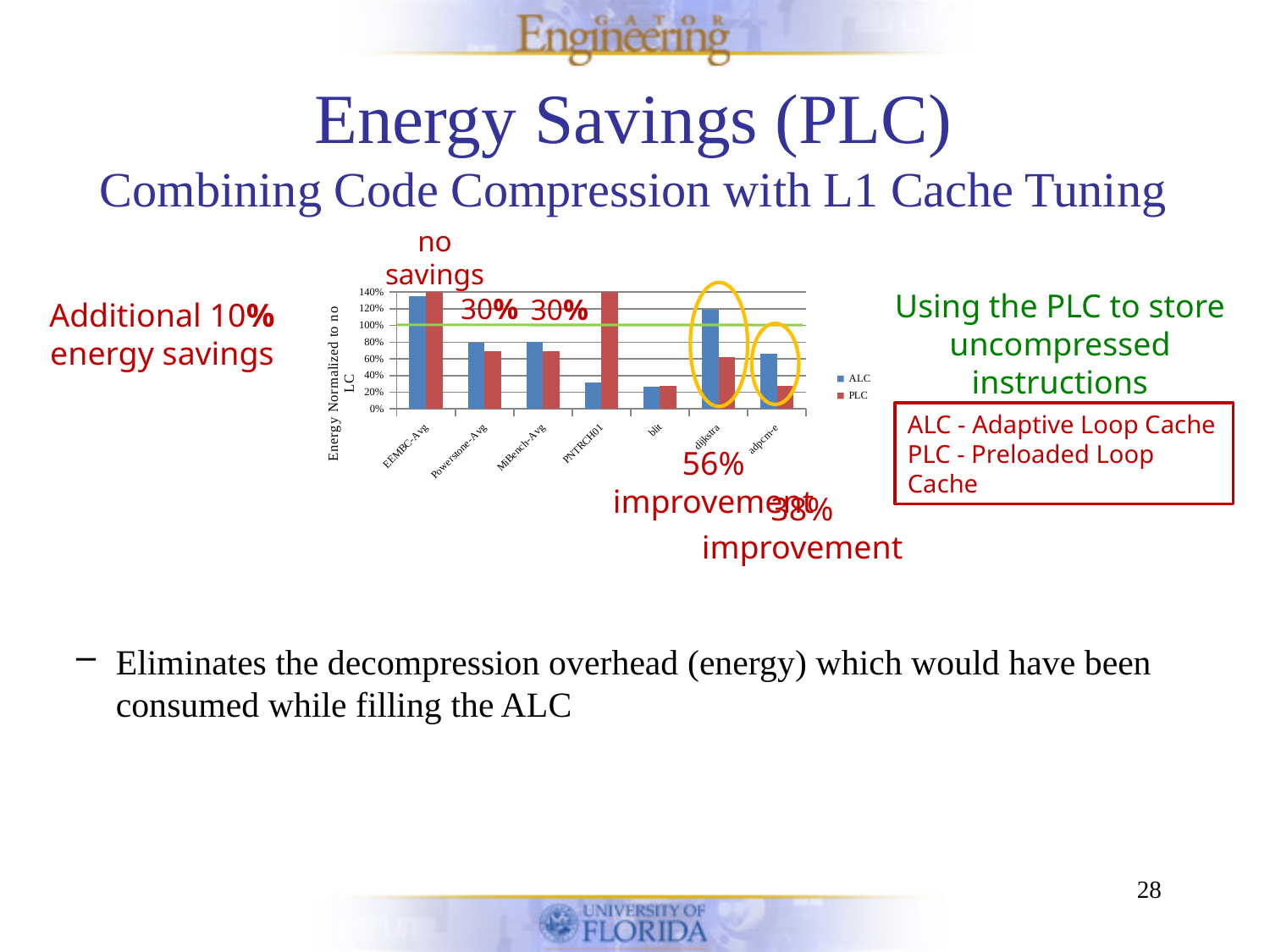
For dijkstra, which series has the larger value, ALC or PLC? ALC Which category has the highest ALC value? EEMBC-Avg Is the PLC value for adpcm-e greater or less than 40%? less How many benchmark categories are plotted along the x axis of the chart? 7 Is the ALC value for dijkstra greater or less than 100%? greater How many series does the chart legend list? 2 What are the two series named in the chart legend? ALC and PLC For PNTRCH01, which series has the larger value, ALC or PLC? PLC Is the PLC value for PNTRCH01 greater or less than 120%? greater What is the label of the chart's vertical axis? Energy Normalized to no LC What kind of chart is shown on the slide? bar chart